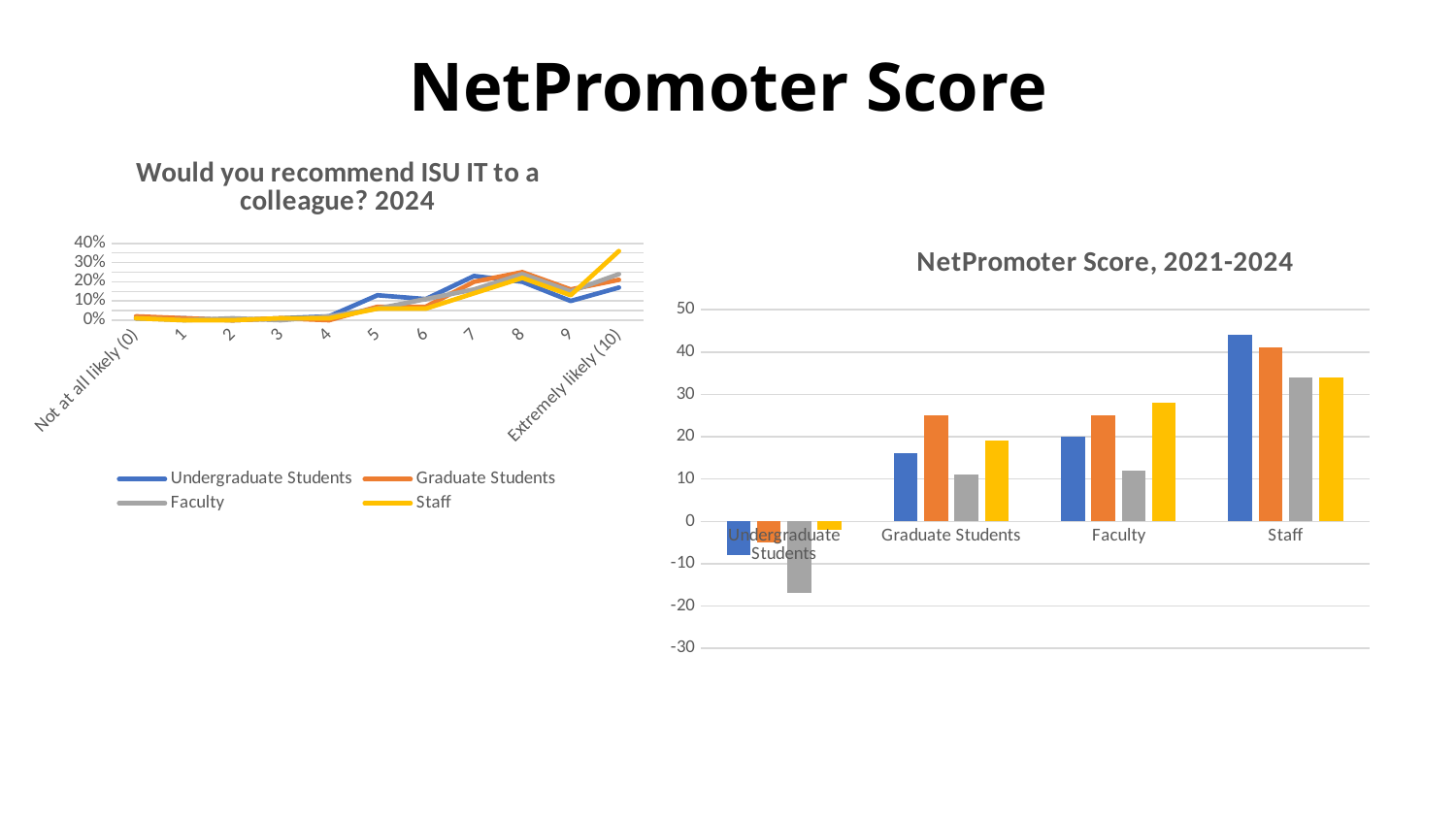
What kind of chart is the 'Would you recommend ISU IT to a colleague? 2024' chart? line chart In the 'NetPromoter Score, 2021-2024' chart, is the value of the blue bar for Staff greater or less than 40? greater How many categories are shown on the x axis of the 'NetPromoter Score, 2021-2024' chart? 4 In the 'Would you recommend ISU IT to a colleague? 2024' chart, which series has the highest value at 'Extremely likely (10)'? Staff In the 'NetPromoter Score, 2021-2024' chart, which category has the highest bars? Staff In the 'Would you recommend ISU IT to a colleague? 2024' chart, do the values generally rise or fall from 'Not at all likely (0)' to 'Extremely likely (10)'? rise In the 'NetPromoter Score, 2021-2024' chart, is the blue bar for Staff larger or smaller than the blue bar for Faculty? larger In the 'NetPromoter Score, 2021-2024' chart, is the value of the orange bar for Graduate Students greater or less than 20? greater How many series does the legend of the 'Would you recommend ISU IT to a colleague? 2024' chart list? 4 In the 'NetPromoter Score, 2021-2024' chart, which category is the only one with negative values? Undergraduate Students What kind of chart is the 'NetPromoter Score, 2021-2024' chart? bar chart In the 'NetPromoter Score, 2021-2024' chart, is the value of the gray bar for Undergraduate Students greater or less than -10? less